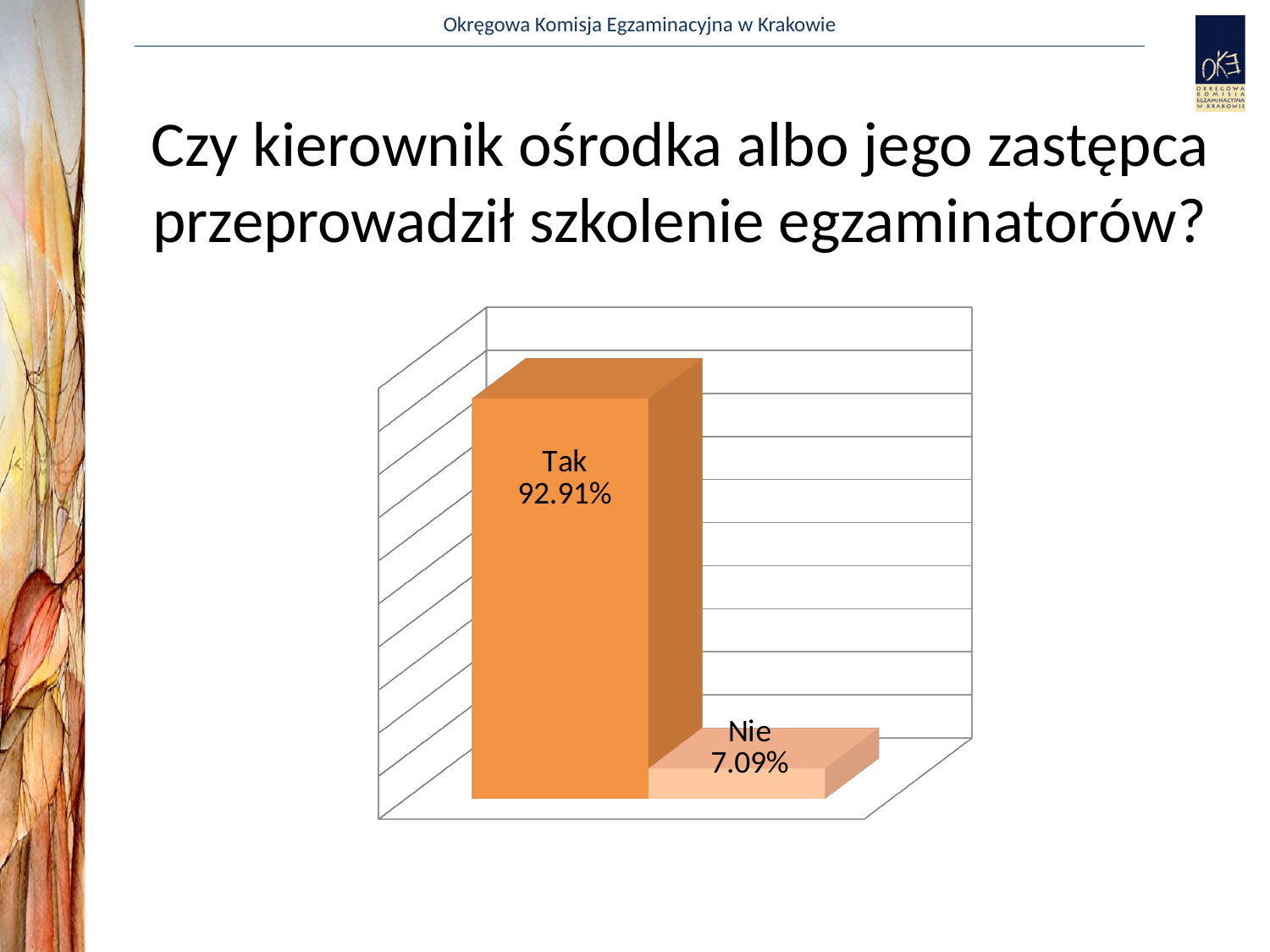
Which category has the lowest value? Nie How many categories are shown in the chart? 2 Which is larger, the value for Tak or the value for Nie? Tak What is the value for Nie? 7.09% What kind of chart is shown on the slide? bar chart Which category has the highest value? Tak What is the difference between the values for Tak and Nie? 85.82% What question does the slide title ask about the chart? Czy kierownik ośrodka albo jego zastępca przeprowadził szkolenie egzaminatorów? What is the total of the values for Tak and Nie? 100% What is the value for Tak? 92.91% Which category is shown with the lighter-coloured bar? Nie